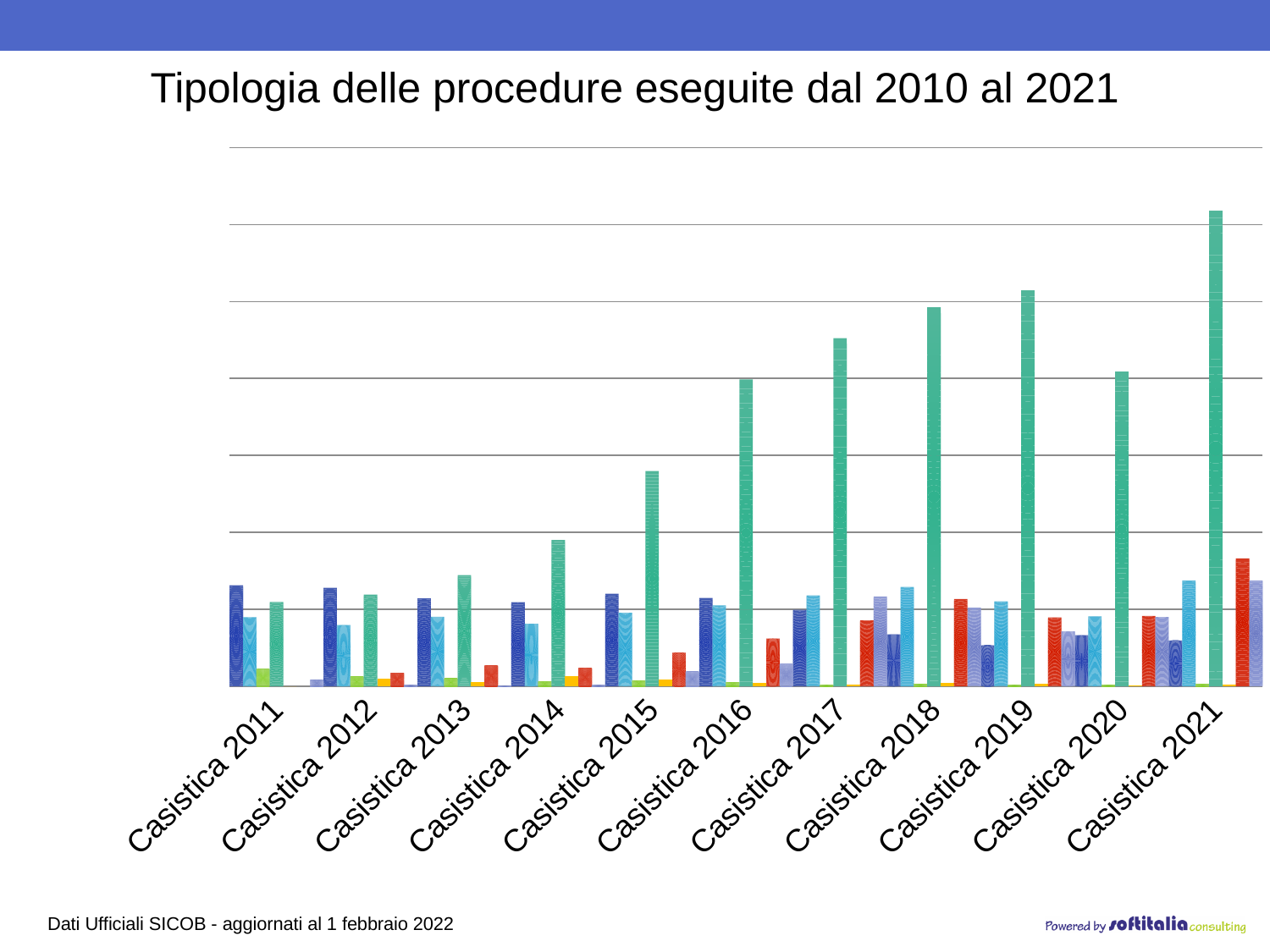
From Casistica 2011 to Casistica 2019, does the tallest bar in each group rise or fall? rise What kind of chart is shown on the slide? bar chart Which category has a taller tallest bar, Casistica 2011 or Casistica 2014? Casistica 2014 Which category has a taller tallest bar, Casistica 2015 or Casistica 2016? Casistica 2016 Which category has a taller tallest bar, Casistica 2019 or Casistica 2020? Casistica 2019 What is the title of the chart? Tipologia delle procedure eseguite dal 2010 al 2021 Among the categories, which has the shortest tallest bar? Casistica 2012 In which category does the tallest bar of the whole chart appear? Casistica 2021 How many categories are shown along the x axis of the chart? 11